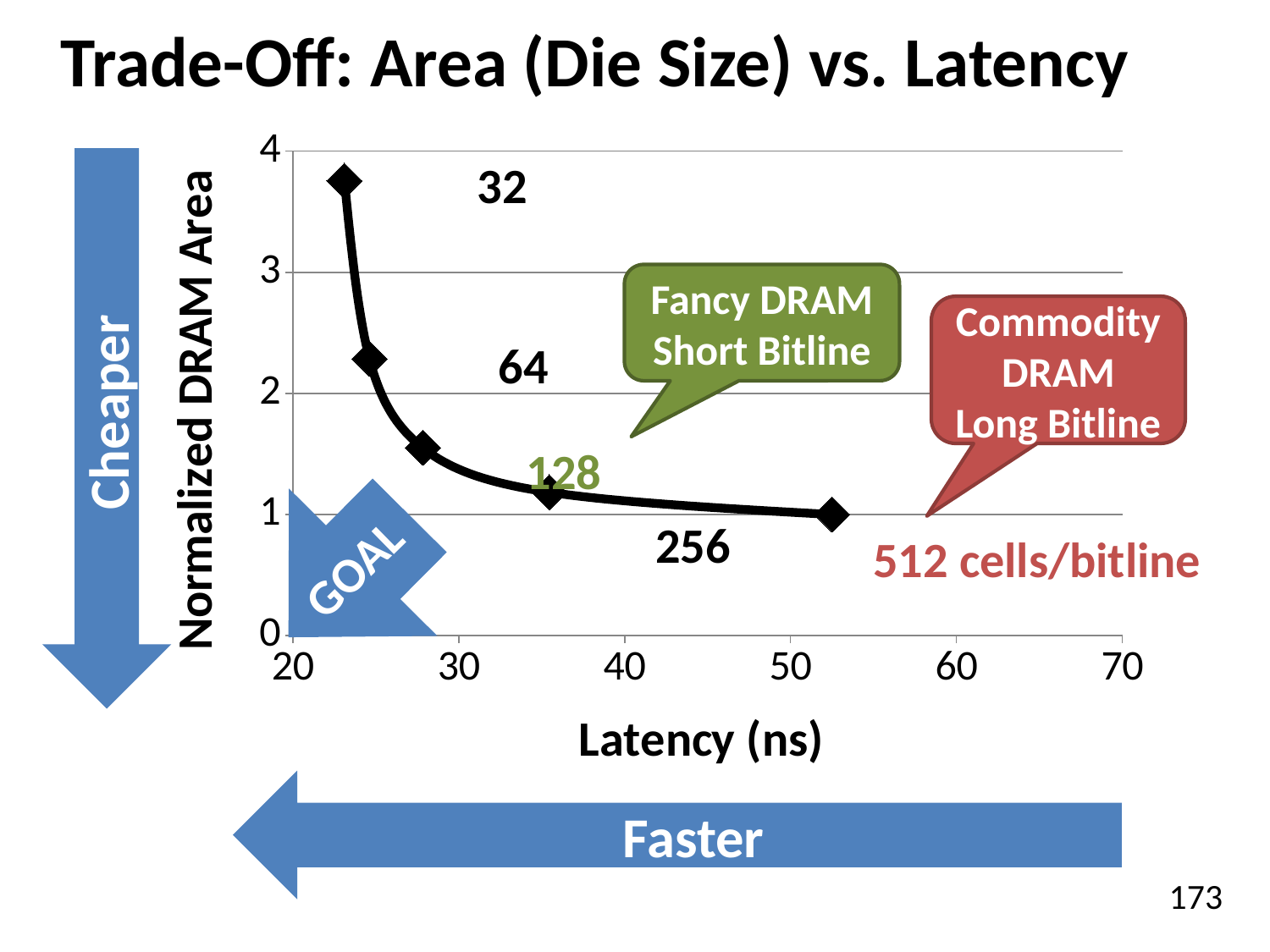
Is the normalized DRAM area for the 32 cells/bitline point greater or less than 3? greater Which labeled point has the highest normalized DRAM area? 32 Which has the larger normalized DRAM area, the 64 point or the 128 point? 64 How many data points are plotted on the chart? 5 Is the normalized DRAM area for the 128 cells/bitline point greater or less than 2? less As latency increases along the x axis, does the normalized DRAM area rise or fall? fall What is the title of the y axis? Normalized DRAM Area Is the normalized DRAM area for the 64 cells/bitline point greater or less than 2? greater What kind of chart is shown on the slide? line chart Which labeled point has the highest latency? 512 cells/bitline What is the title of the x axis? Latency (ns)